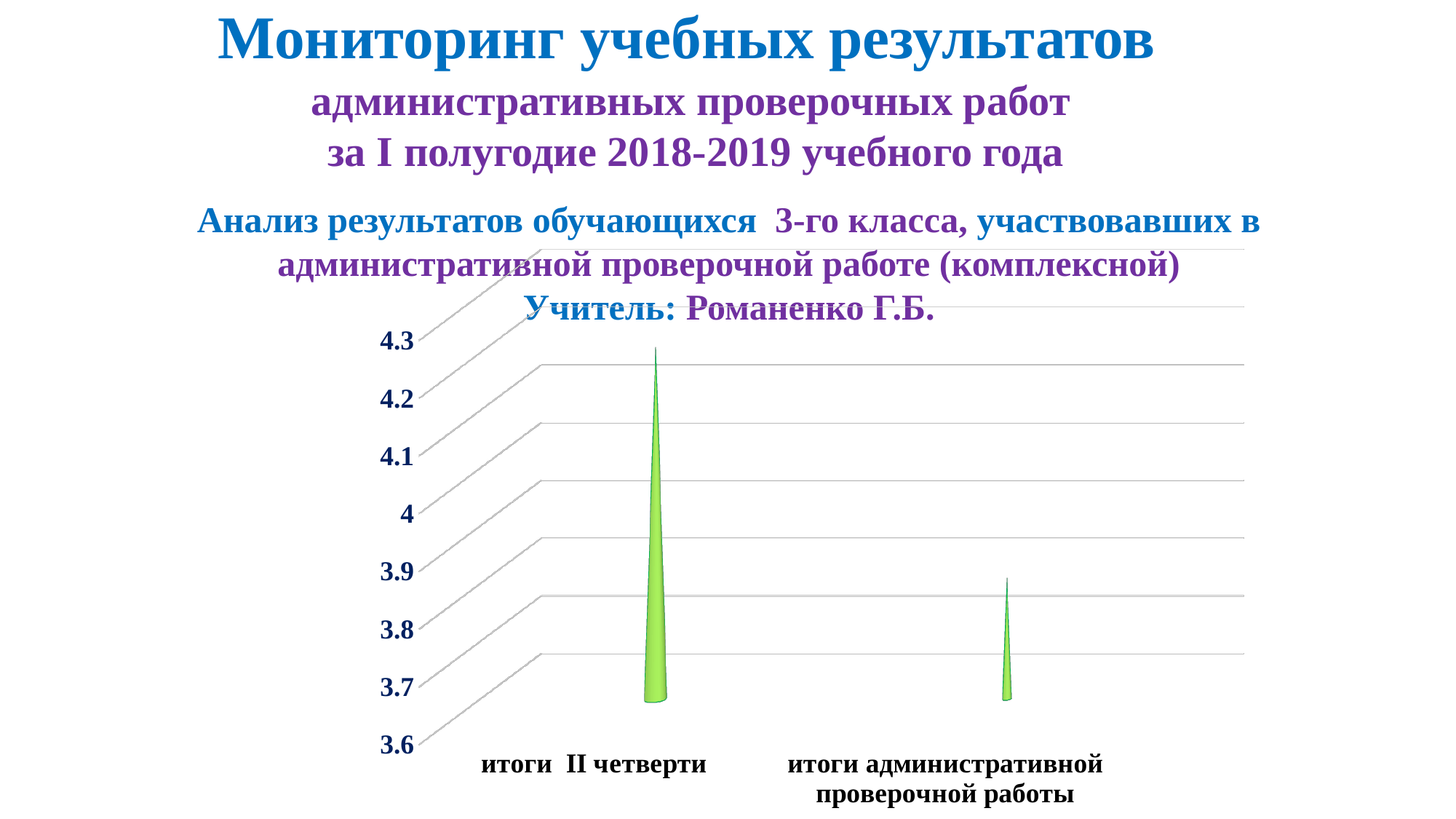
Which is larger: the value for итоги II четверти or the value for итоги административной проверочной работы? итоги II четверти Do the values rise or fall from итоги II четверти to итоги административной проверочной работы? fall What is the lowest value shown on the vertical axis of the chart? 3.6 Which category has the highest value on the chart? итоги II четверти What kind of chart is shown on the slide? bar chart Is the value for итоги II четверти greater or less than 4.1? greater How many categories are plotted on the chart? 2 Is the value for итоги административной проверочной работы greater or less than 4? less What colour are the bars on the chart? green Is the value for итоги II четверти greater or less than 4? greater Which category has the lowest value on the chart? итоги административной проверочной работы